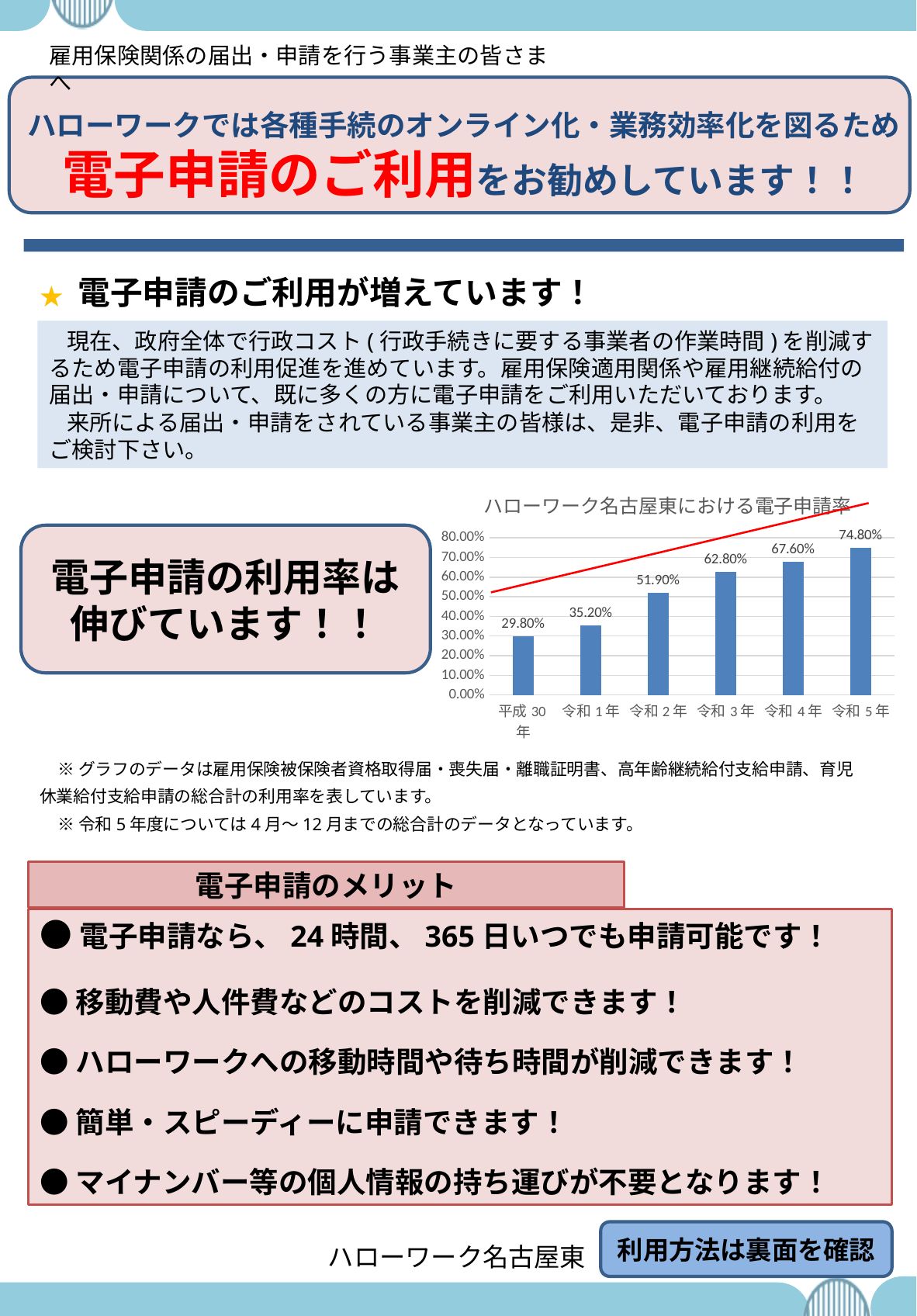
What is the value shown for 令和 2 年? 51.90% What kind of chart is used to show the electronic application rate? bar chart Which year has the highest electronic application rate? 令和 5 年 What is the difference between the rates for 令和 3 年 and 令和 2 年? 10.90% Do the values rise or fall from 平成 30 年 to 令和 5 年? rise Is the value for 令和 3 年 greater or less than 60.00%? greater What is the electronic application rate for 平成 30 年? 29.80% Which year has the lowest electronic application rate? 平成 30 年 What is the difference between the rates for 令和 5 年 and 平成 30 年? 45.00% How many years are shown on the x axis of the chart? 6 What is the electronic application rate for 令和 5 年? 74.80% Which is larger, the rate for 令和 1 年 or the rate for 令和 4 年? 令和 4 年